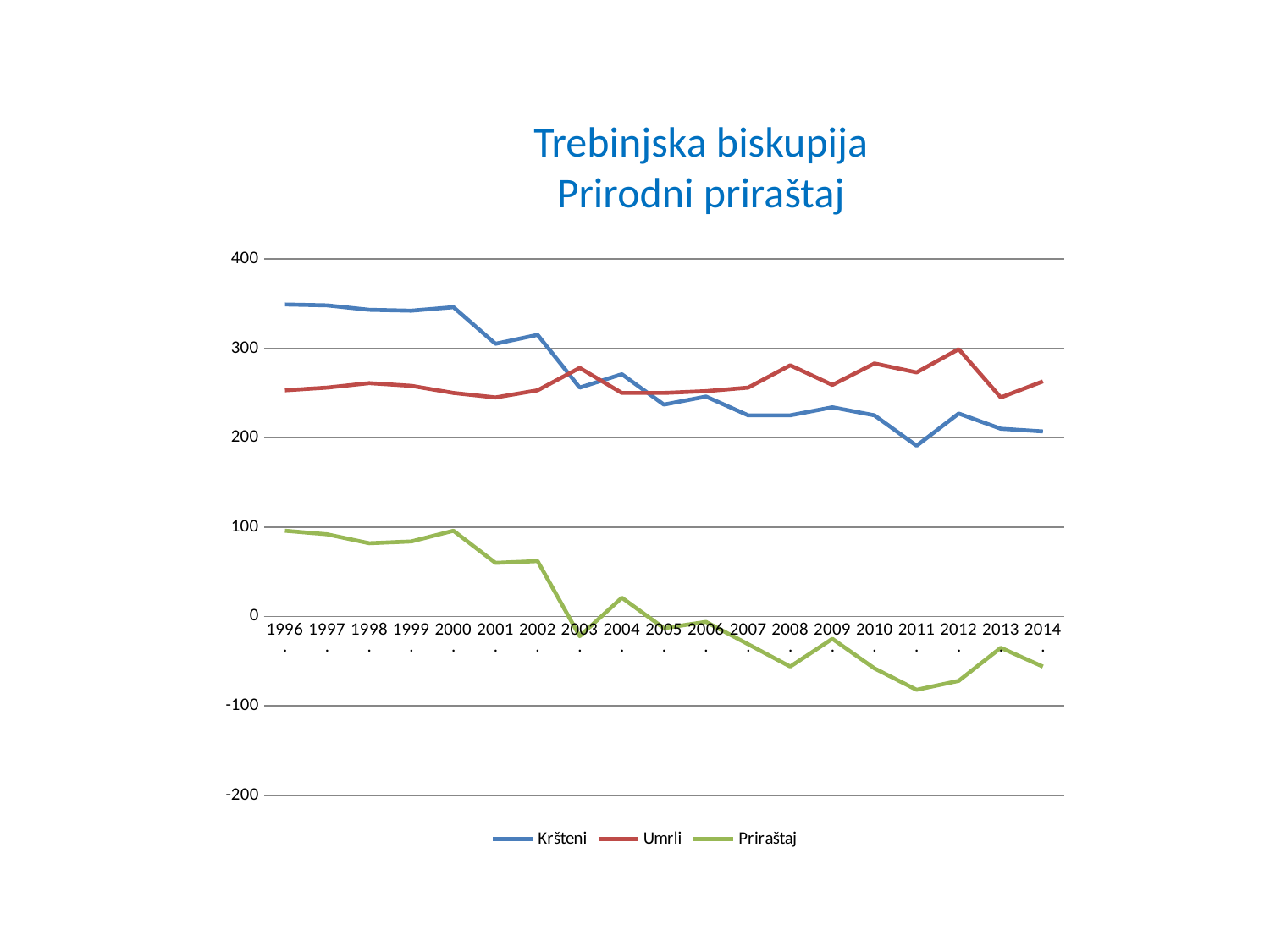
Is the value for Kršteni in 1996 greater or less than 300? greater How many years are plotted along the x axis? 19 Do the values for Priraštaj generally rise or fall from 1996 to 2014? fall Do the values for Kršteni generally rise or fall from 1996 to 2014? fall Is the value for Kršteni in 2011 greater or less than 200? less What is the title of the chart? Trebinjska biskupija Prirodni priraštaj Which series is drawn in green? Priraštaj How many series does the legend list? 3 Is the value for Priraštaj in 2011 greater or less than 0? less In which year is the value for Priraštaj lowest? 2011 In 2014, which is larger, Kršteni or Umrli? Umrli What kind of chart is shown on the slide? line chart